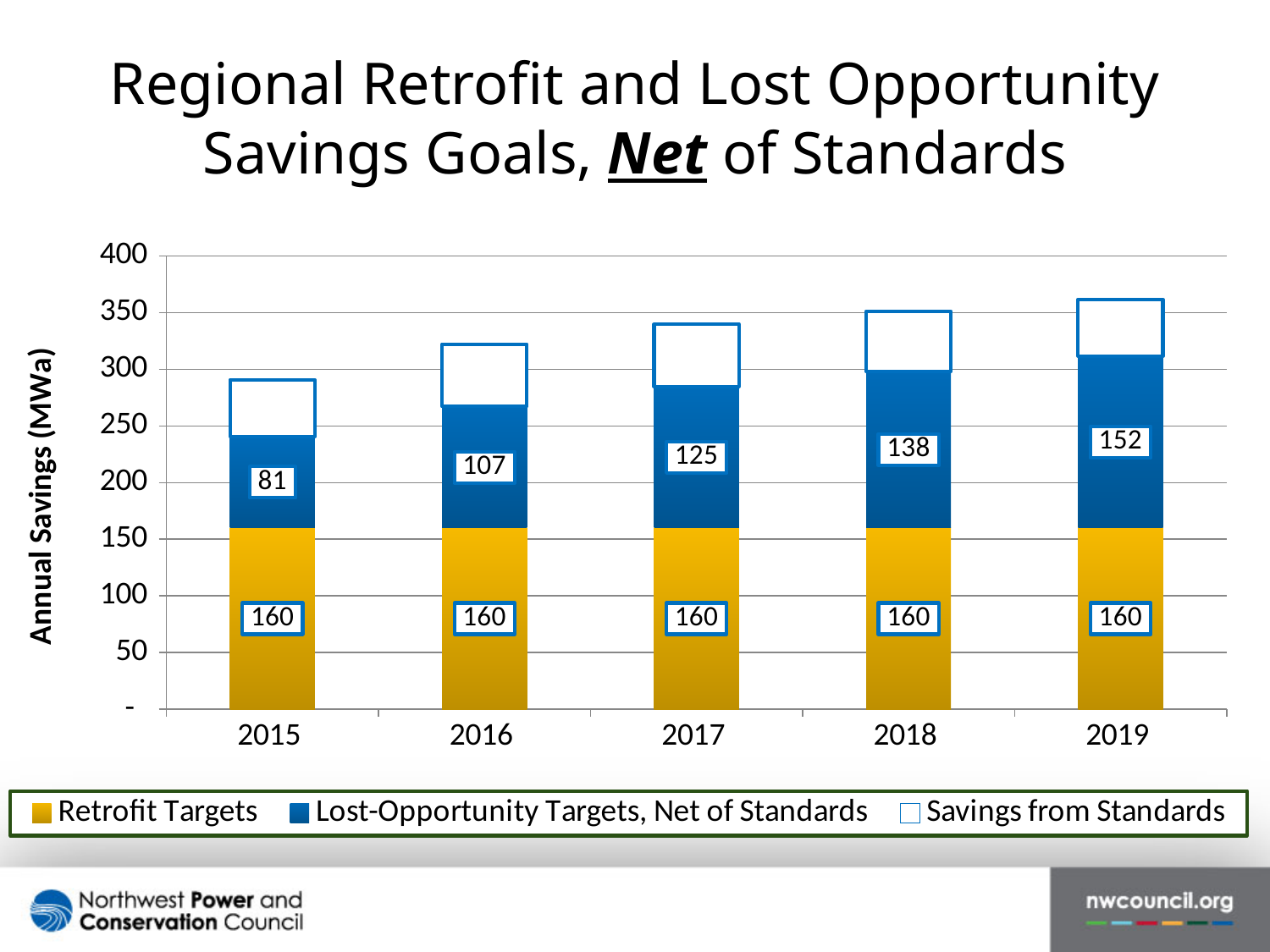
What is the Lost-Opportunity Targets, Net of Standards value for 2015? 81 Is the total height of the 2019 stacked bar greater or less than 350? greater What is the Retrofit Targets value for 2017? 160 How many years are shown on the x axis? 5 Which year has the highest Lost-Opportunity Targets, Net of Standards value? 2019 What is the Lost-Opportunity Targets, Net of Standards value for 2019? 152 Do the Lost-Opportunity Targets, Net of Standards values rise or fall from 2015 to 2019? rise Is the Lost-Opportunity Targets, Net of Standards value larger in 2016 or in 2018? 2018 What is the difference between the Lost-Opportunity Targets, Net of Standards values for 2019 and 2015? 71 How many series does the legend list? 3 Which year has the lowest Lost-Opportunity Targets, Net of Standards value? 2015 Is the total height of the 2015 stacked bar greater or less than 300? less